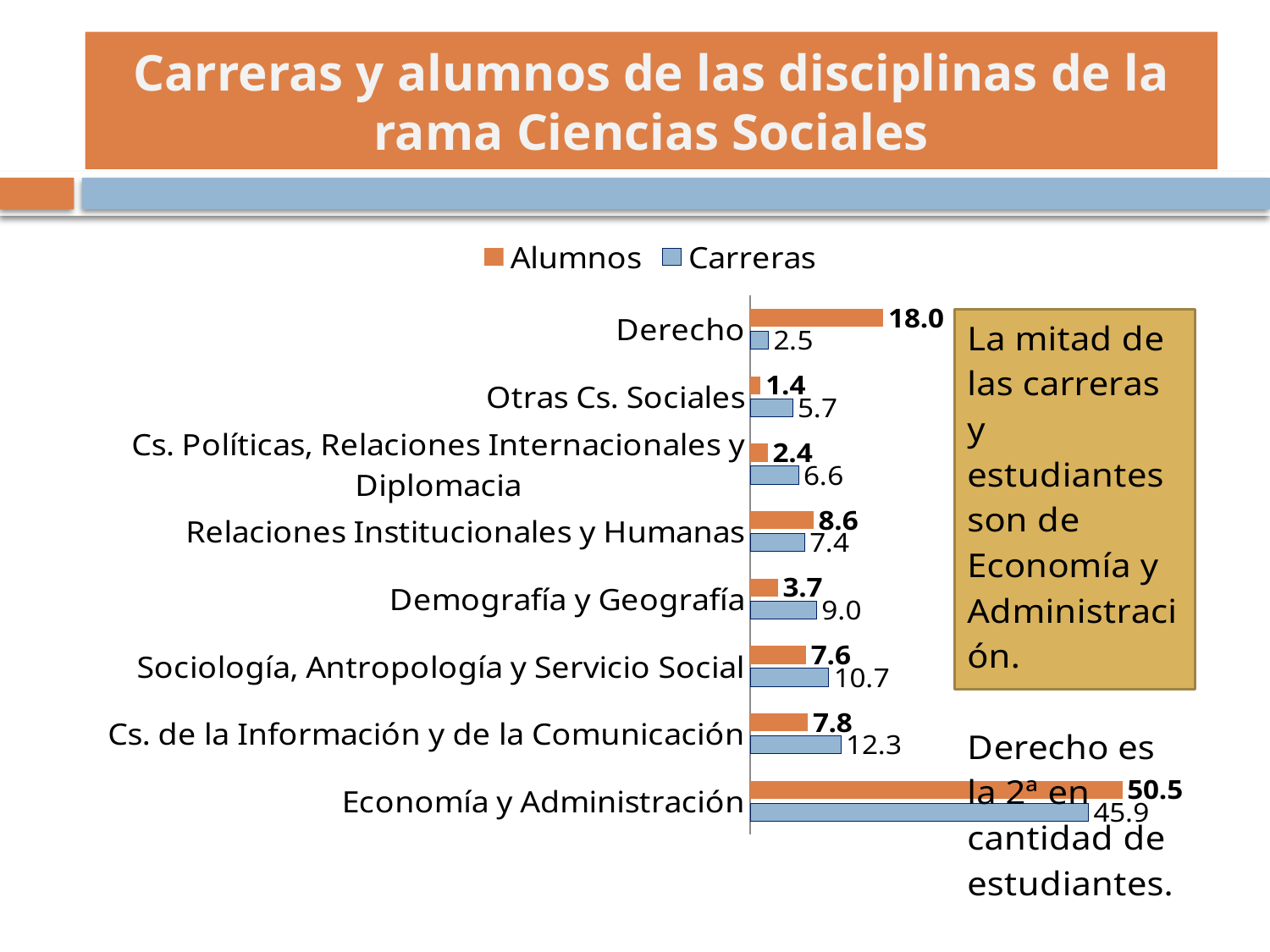
What is the Carreras value for Economía y Administración? 45.9 What is the difference between the Alumnos and Carreras values for Economía y Administración? 4.6 How many series does the legend list? 2 Which category has the highest Alumnos value? Economía y Administración What kind of chart is shown on the slide? Bar chart Which is larger for Demografía y Geografía, the Alumnos value or the Carreras value? Carreras What is the Carreras value for Sociología, Antropología y Servicio Social? 10.7 How many categories are shown in the chart? 8 What is the Alumnos value for Derecho? 18.0 Which category has the lowest Alumnos value? Otras Cs. Sociales Which category has the lowest Carreras value? Derecho What is the difference between the Alumnos and Carreras values for Derecho? 15.5